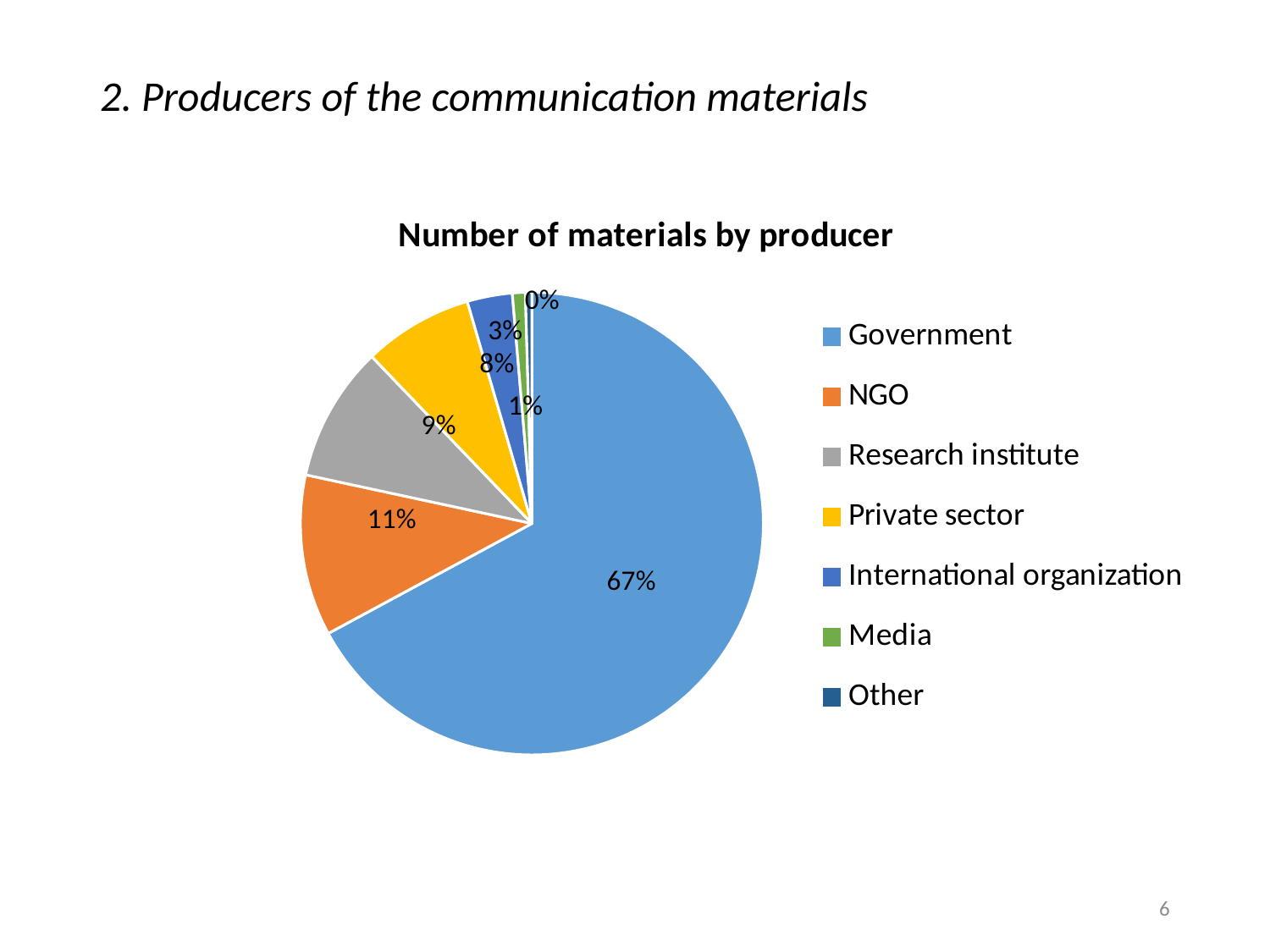
What share of the pie does Research institute account for? 9% What share of the pie does Government account for? 67% What is the difference in percentage points between the Government and NGO slices? 56 Which producer has the smallest slice of the pie? Other What share of the pie does NGO account for? 11% Which producer has the largest slice of the pie? Government How many producer categories does the legend list? 7 Which slice is larger, Research institute or Private sector? Research institute What kind of chart is shown on the slide? pie chart What is the title of the chart? Number of materials by producer